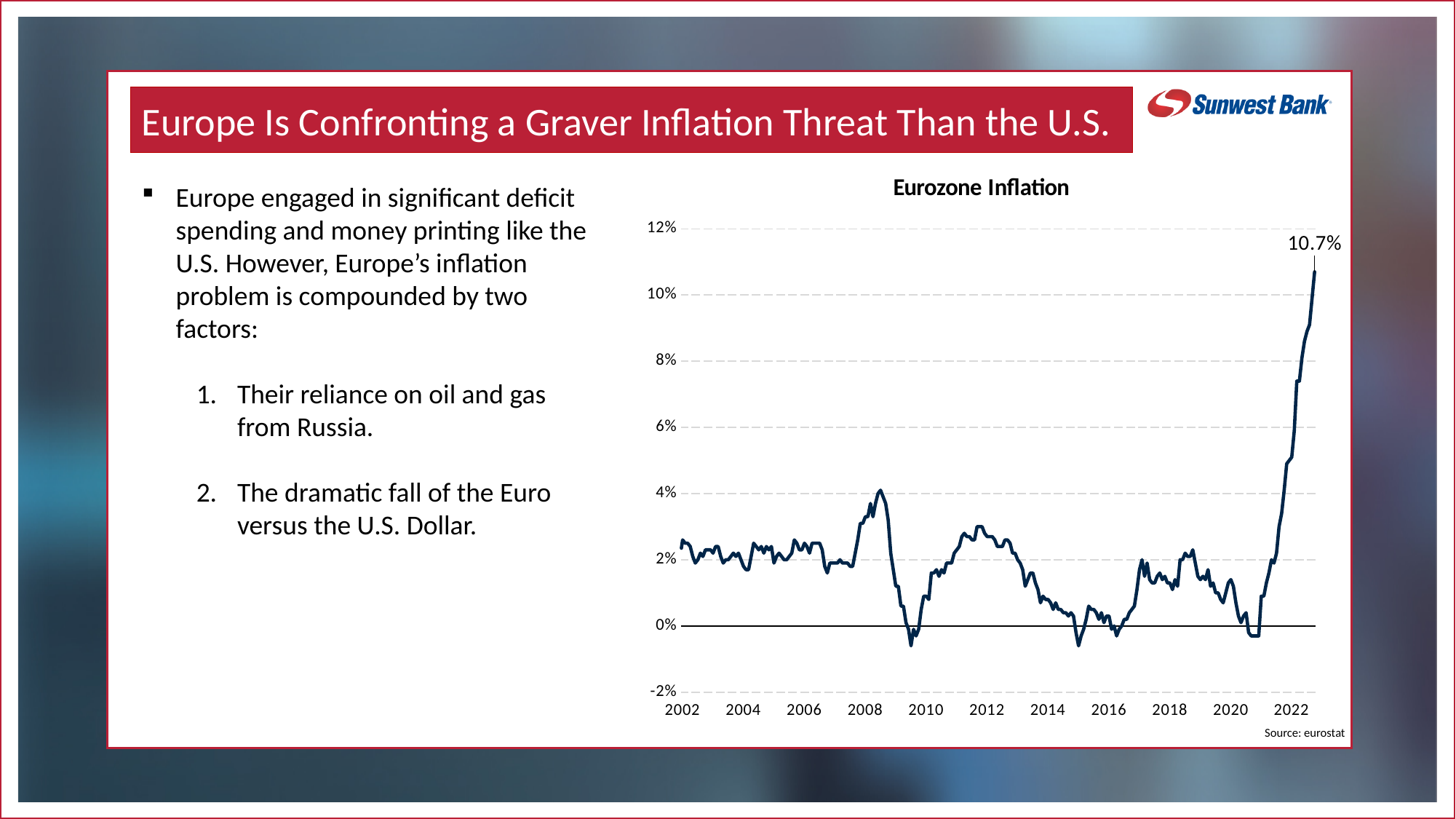
What kind of chart is shown on the slide? line chart What is the title of the chart? Eurozone Inflation Is the lowest point of Eurozone inflation around 2009 greater or less than 0%? less Is the Eurozone inflation value at the start of the line in 2002 greater or less than 4%? less Which year shows the highest Eurozone inflation on the chart, 2008 or 2022? 2022 What is the lowest value shown on the vertical axis? -2% Is the Eurozone inflation value at the end of the line in 2022 greater or less than 10%? greater What is the highest value shown on the vertical axis? 12% Does Eurozone inflation rise or fall between 2021 and 2022? rise What is the value of the data label shown at the end of the line in 2022? 10.7%